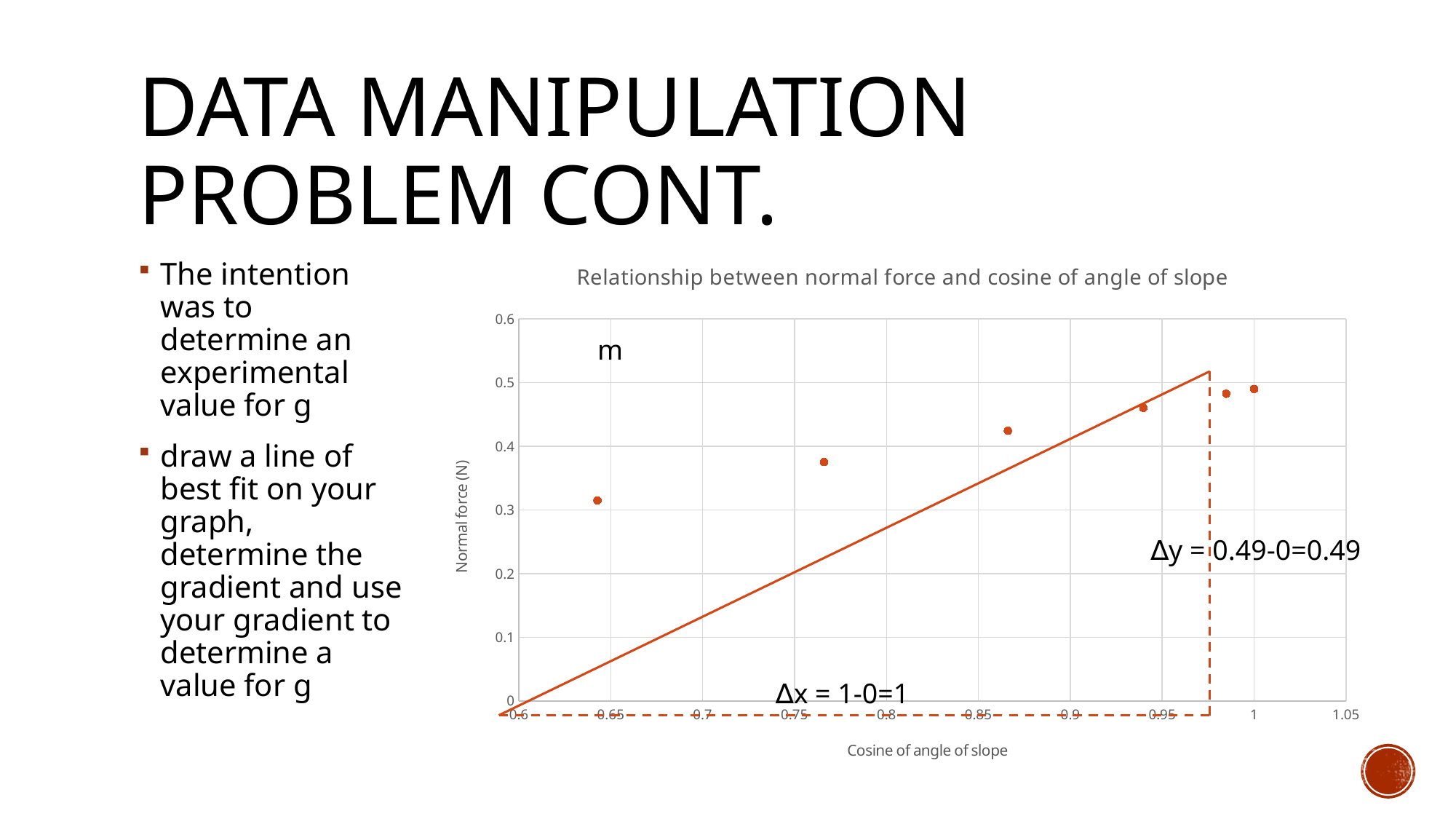
Which plotted point has the lowest normal force value? the leftmost point, near a cosine of 0.65 Is the normal force for the data point at a cosine of 1 greater or less than 0.4? greater What is the title of the chart? Relationship between normal force and cosine of angle of slope Is the normal force for the data point near a cosine of 0.75 greater or less than 0.3? greater What is the label of the vertical axis of the chart? Normal force (N) Is the normal force for the leftmost data point (cosine of about 0.65) greater or less than 0.4? less How many data points are plotted on the chart? 6 What kind of chart is shown on the slide? scatter chart As the cosine of angle of slope increases along the x axis, do the normal force values rise or fall? rise Which data point has the lowest normal force: the one near a cosine of 0.65 or the one near a cosine of 1? the one near a cosine of 0.65